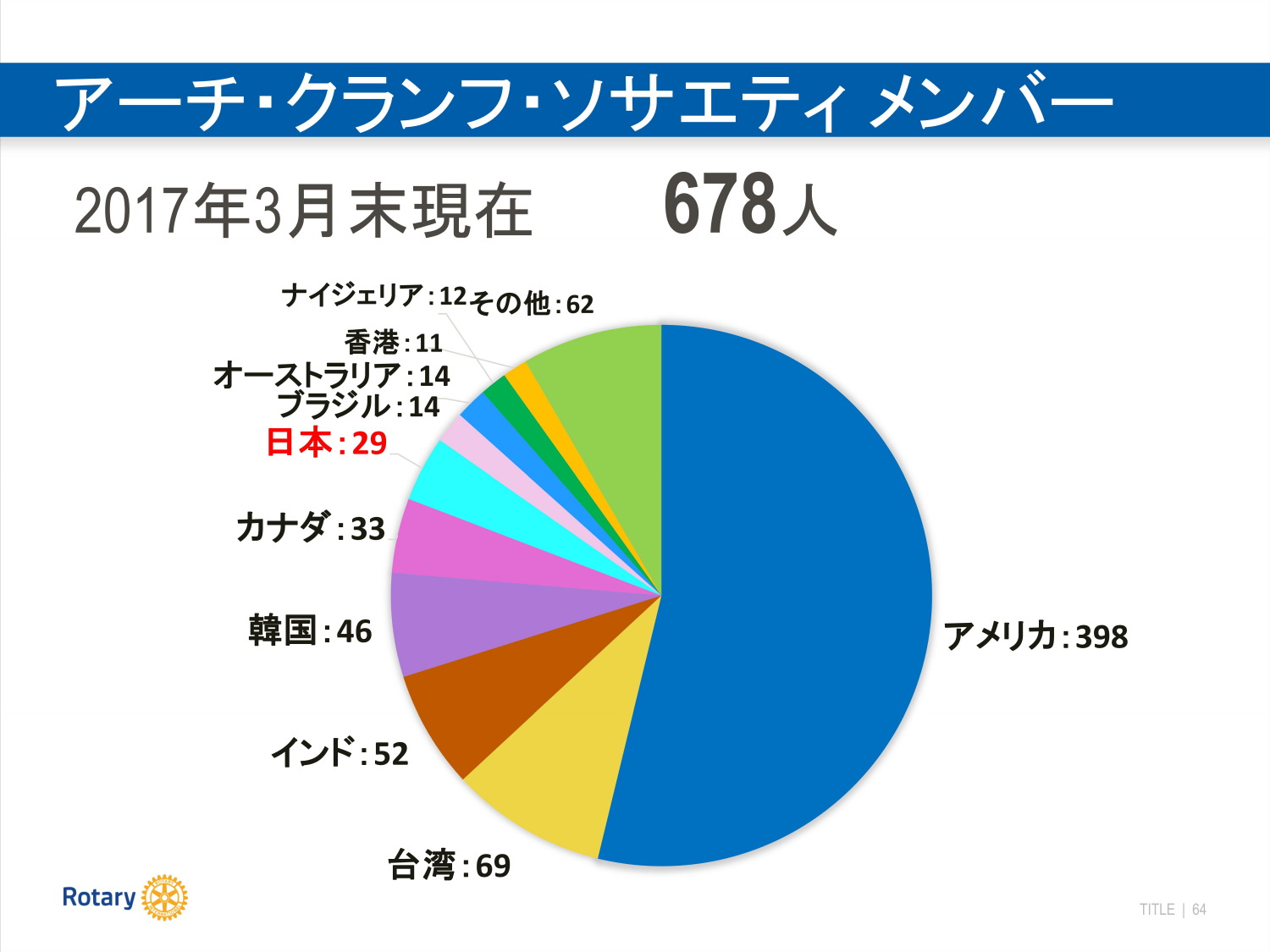
What is the value for アメリカ? 398 What kind of chart is shown on the slide? pie chart What is the difference between the values for アメリカ and 台湾? 329 Which category's label is printed in red? 日本 Which is larger, the value for 台湾 or the value for インド? 台湾 What is the value for 台湾? 69 Which category has the smallest value? 香港 What is the value for カナダ? 33 How many slices does the pie chart have? 11 What is the value for 日本? 29 What is the difference between the values for インド and 韓国? 6 Which category has the largest slice? アメリカ